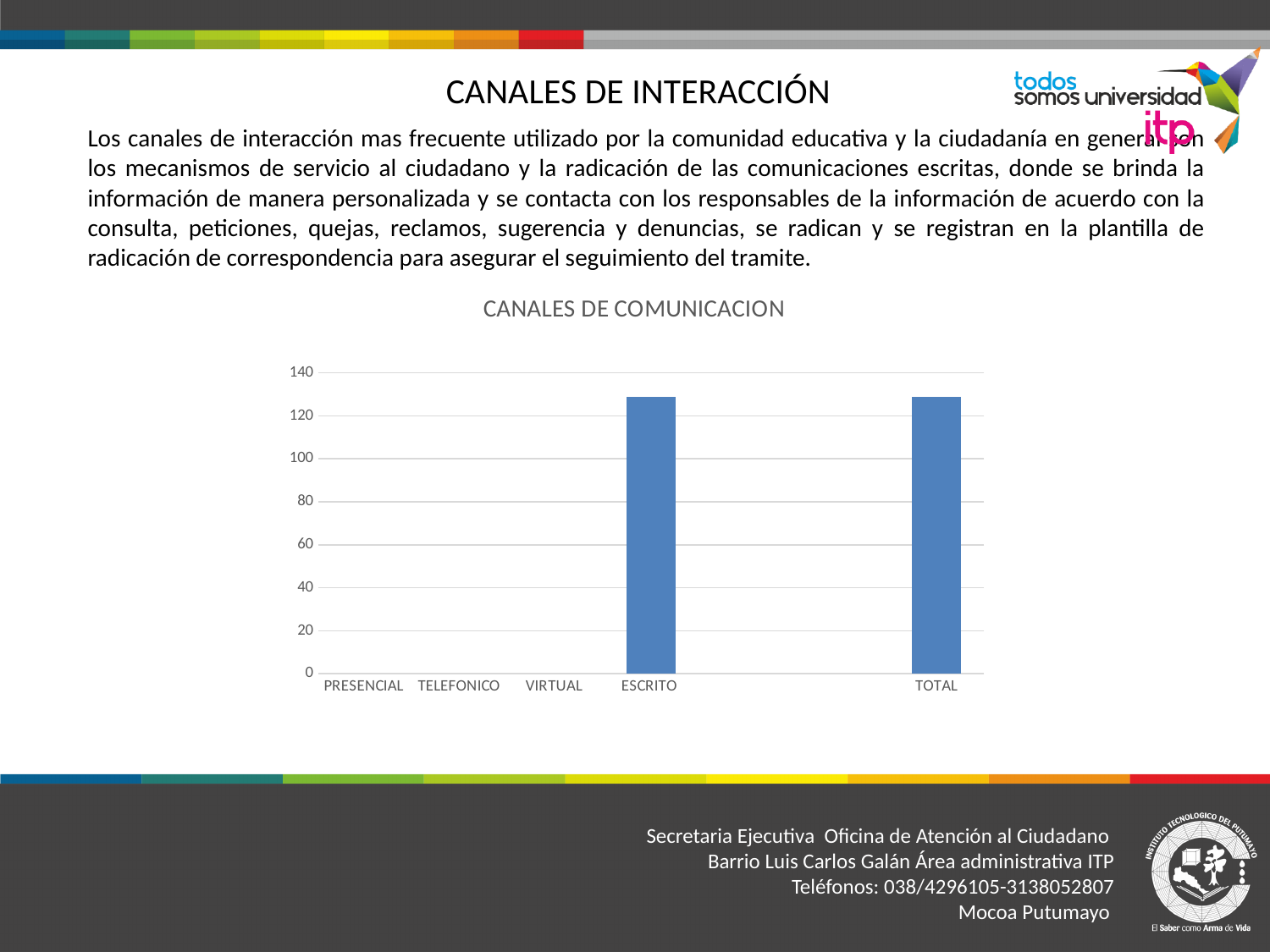
Is the value for ESCRITO greater or less than 140? less Is the value for TOTAL greater or less than 100? greater What is the title of the chart on the slide? CANALES DE COMUNICACION Is the value for TOTAL greater or less than 140? less How many bars are visible in the chart? 2 What is the highest value shown on the vertical axis of the chart? 140 What kind of chart is shown under the title CANALES DE COMUNICACION? Bar chart Which categories in the chart have a visible bar? ESCRITO and TOTAL